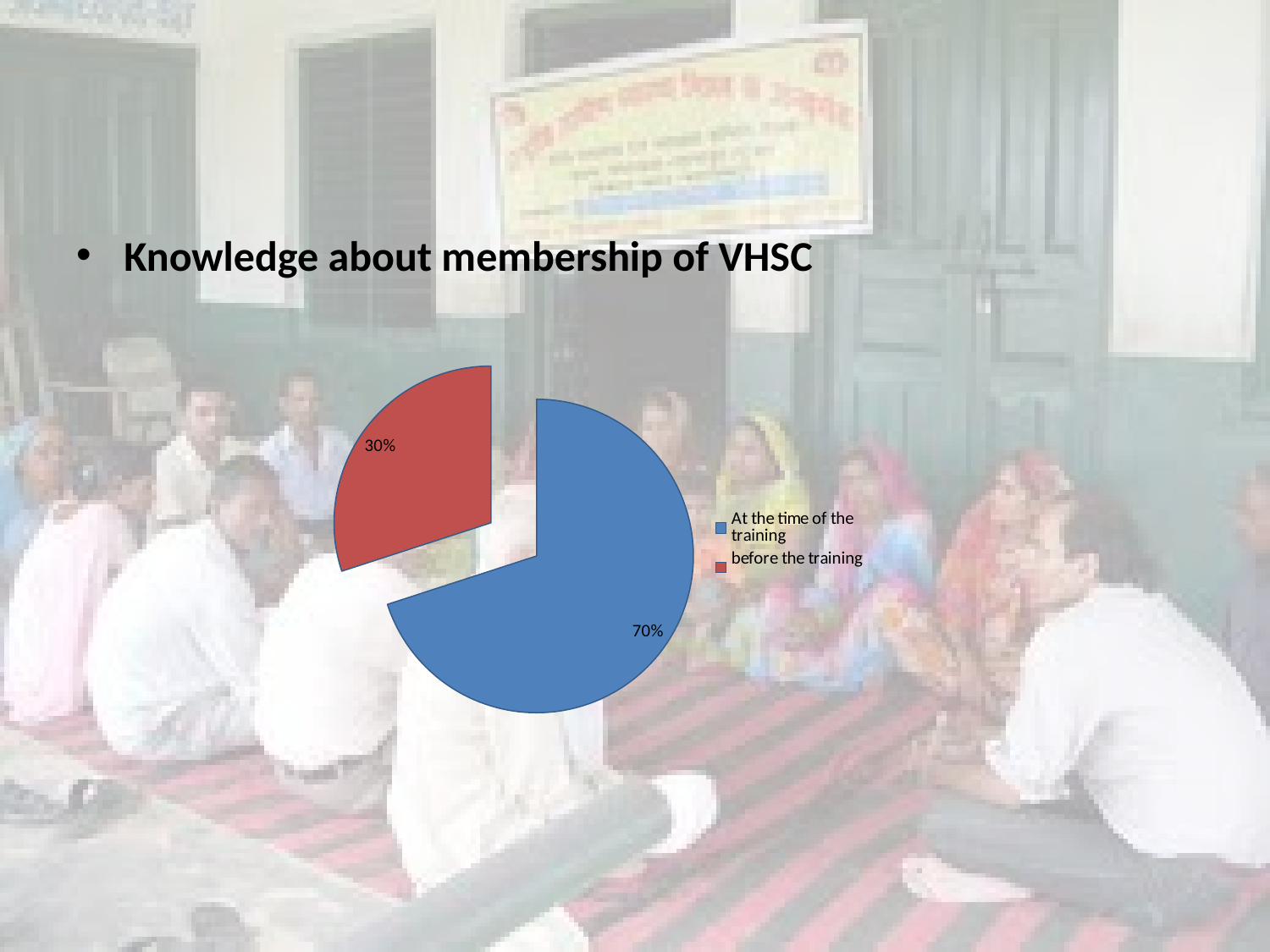
Which slice is the largest? At the time of the training What colour is the "before the training" slice? red Which slice is the smallest? before the training What share of the pie is labelled "At the time of the training"? 70% Which is larger: the "At the time of the training" slice or the "before the training" slice? At the time of the training What colour is the "At the time of the training" slice? blue How many slices does the pie chart have? 2 What share of the pie is labelled "before the training"? 30% What is the difference in percentage points between the "At the time of the training" slice and the "before the training" slice? 40 What kind of chart is shown on the slide? pie chart How many entries does the legend list? 2 What is the total of the two slice percentages shown? 100%